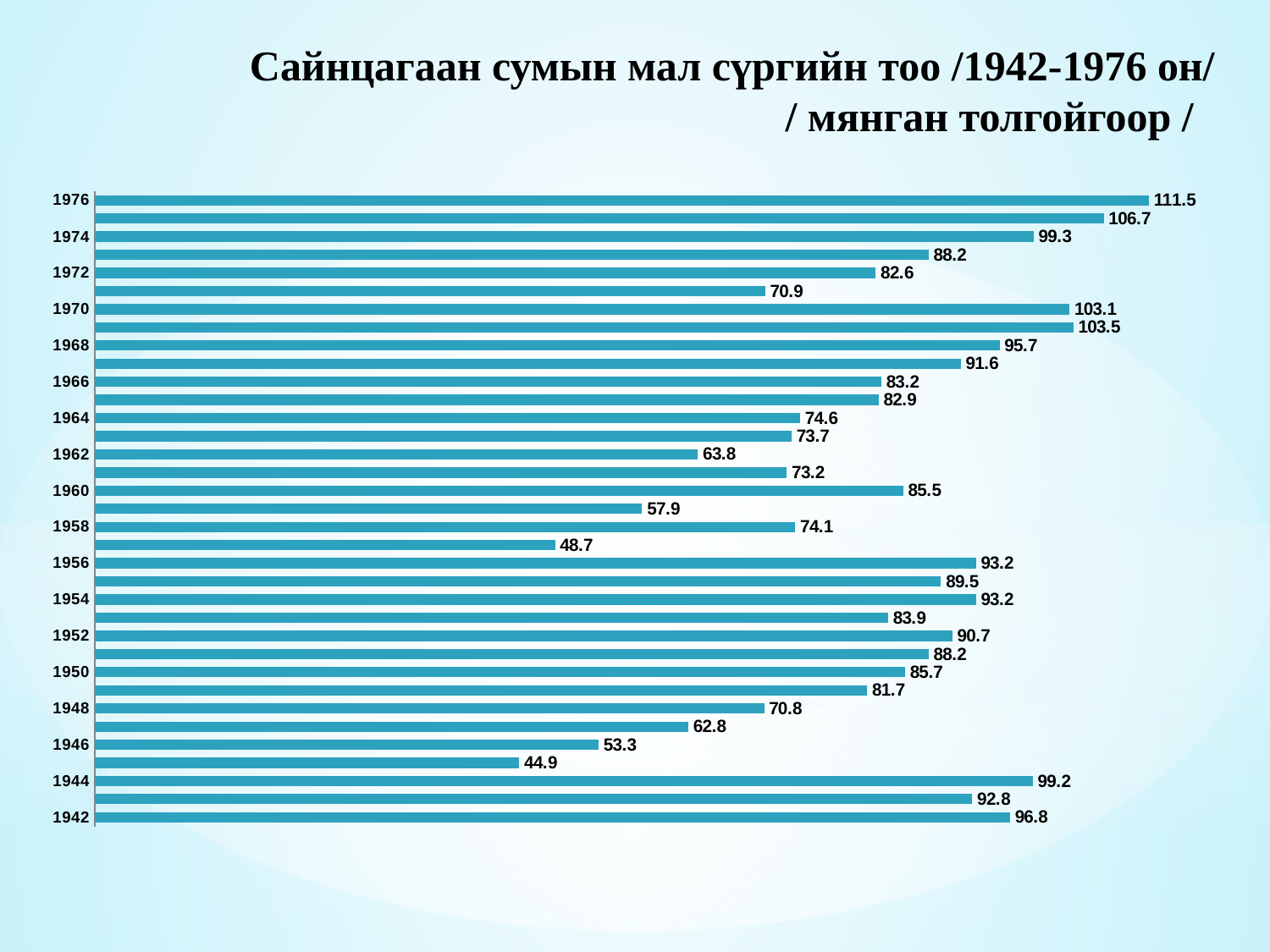
How many bars are plotted on the chart? 35 What is the value for 1970? 103.1 What is the difference between the values for 1970 and 1972? 20.5 What is the value for 1976? 111.5 Which is larger, the value for 1960 or the value for 1962? 1960 Do the values rise or fall from 1972 to 1976? rise What is the smallest value labeled on the chart? 44.9 What type of chart is shown on the slide? bar chart What is the value for 1942? 96.8 Which year has the highest value? 1976 What is the difference between the values for 1976 and 1942? 14.7 What is the value for 1958? 74.1